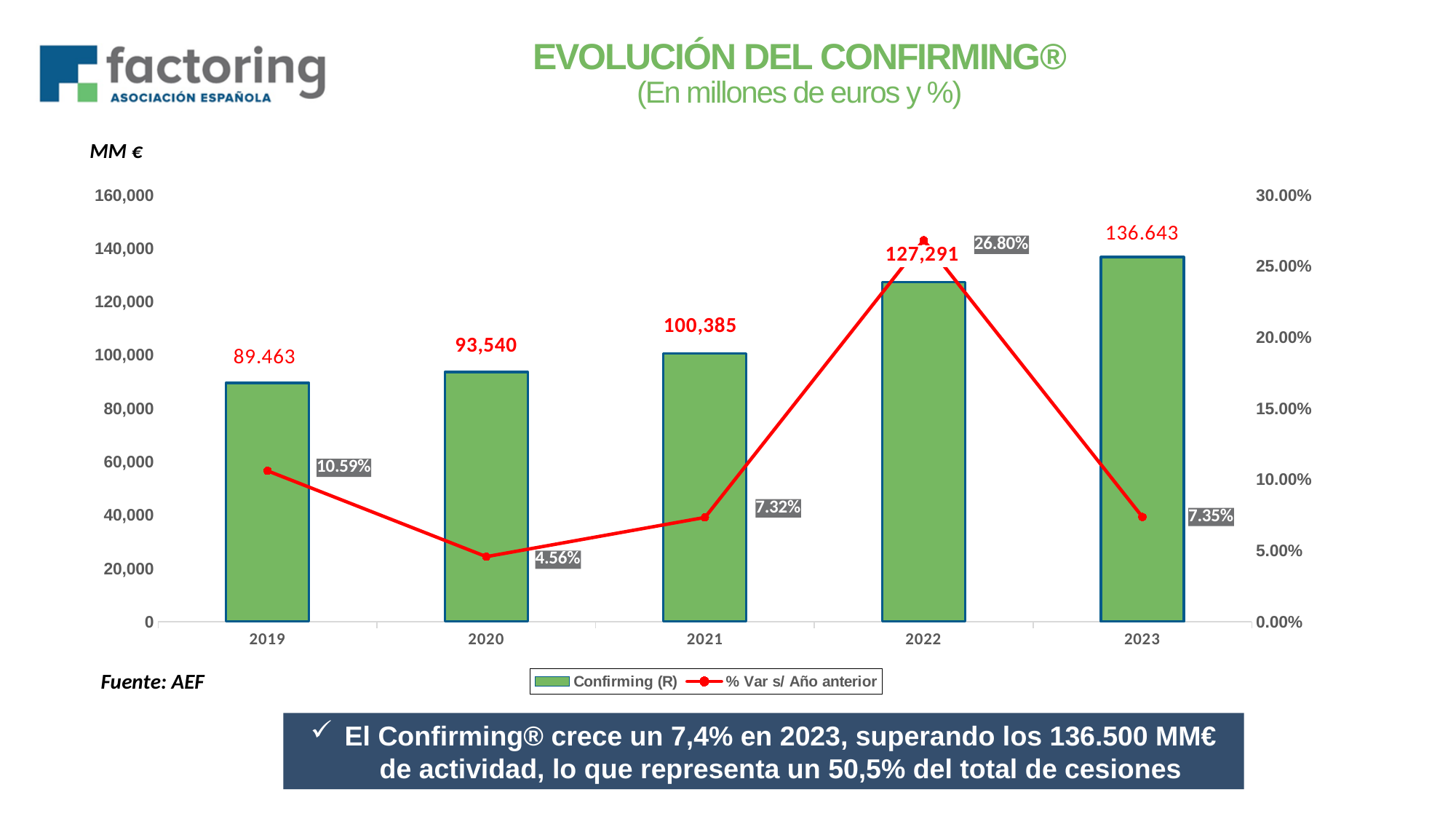
What is the Confirming (R) value for 2019? 89.463 Do the Confirming (R) bar values rise or fall from 2019 to 2023? rise What is the difference between the Confirming (R) values for 2021 and 2020? 6,845 How many series does the legend list? 2 How many years are shown on the x axis? 5 What is the Confirming (R) value for 2021? 100,385 Which is larger, the % Var s/ Año anterior for 2019 or for 2021? 2019 Which year has the lowest % Var s/ Año anterior value? 2020 What is the % Var s/ Año anterior value for 2022? 26.80% Which year has the highest Confirming (R) value? 2023 What is the % Var s/ Año anterior value for 2020? 4.56% What is the difference between the % Var s/ Año anterior values for 2022 and 2023? 19.45%